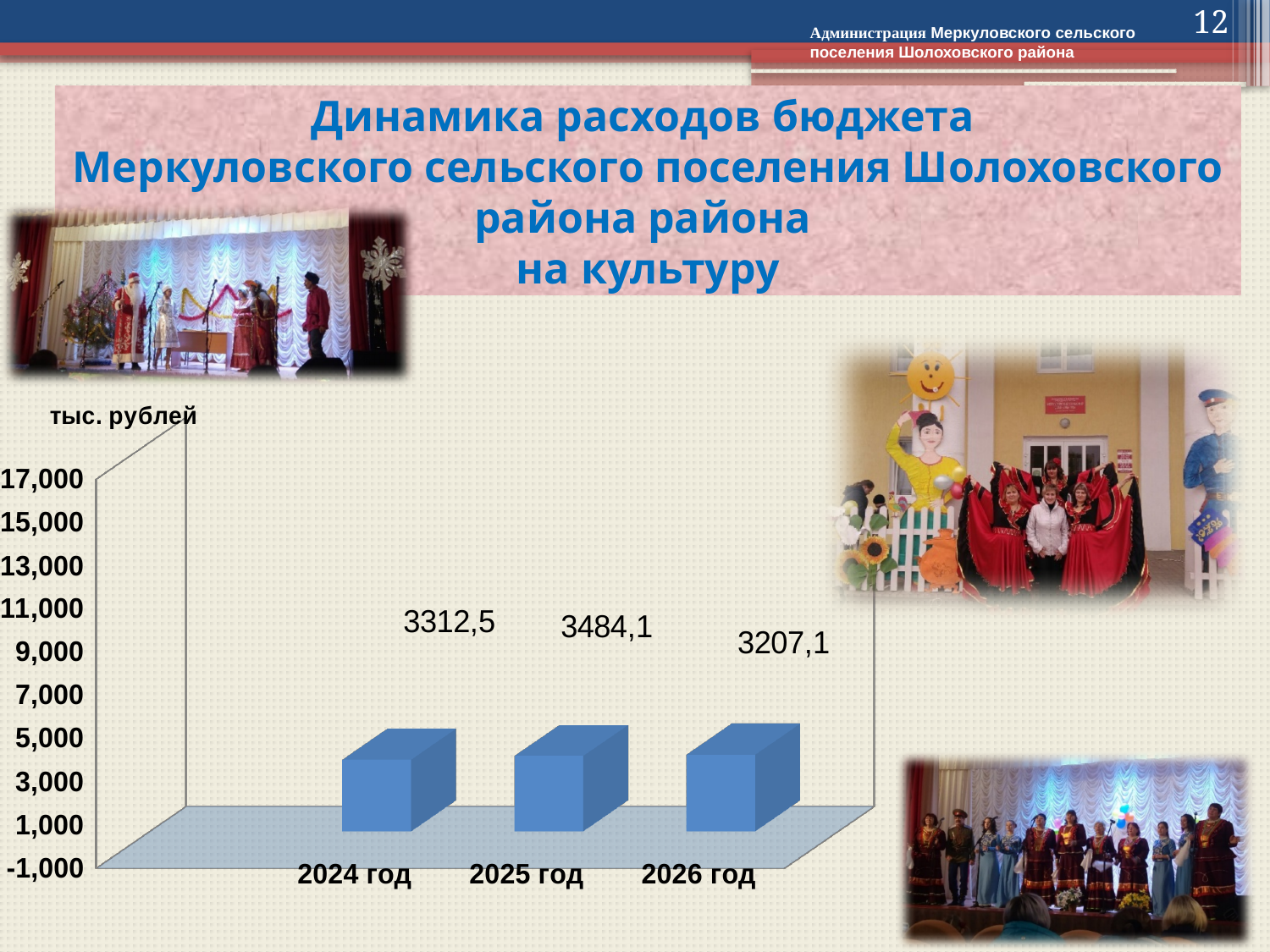
What kind of chart is shown on the slide? bar chart What is the value for 2024 год? 3312,5 Which is larger, the value for 2024 год or the value for 2026 год? 2024 год Which year has the lowest value? 2026 год What is the value for 2026 год? 3207,1 Is the value for 2025 год greater or less than 5,000? less What is the value for 2025 год? 3484,1 What is the difference between the values for 2025 год and 2024 год? 171,6 What unit is shown above the vertical axis of the chart? тыс. рублей What is the difference between the values for 2025 год and 2026 год? 277,0 Which year has the highest value? 2025 год How many years are shown on the x axis? 3